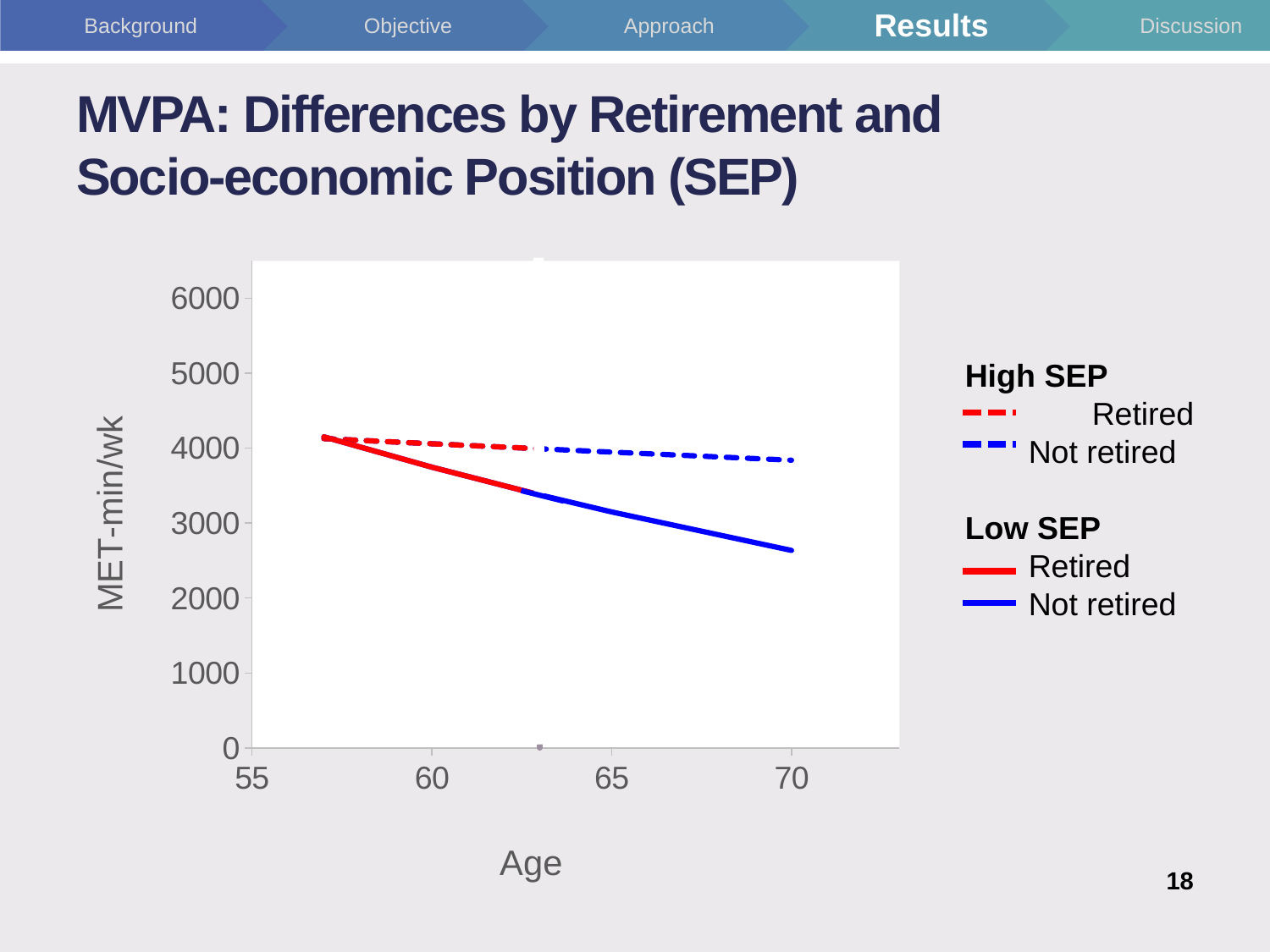
Do the MET-min/wk values for the High SEP Not retired series rise or fall as age increases? fall What kind of chart is shown on the slide? line chart How many series does the legend list in total? 4 What is the label on the x axis of the chart? Age Is the value for the High SEP Not retired series at age 70 greater or less than 3000? greater What is the label on the y axis of the chart? MET-min/wk Is the value for the High SEP Not retired series at age 70 greater or less than 4000? less At age 70, which series has the higher value: High SEP Not retired or Low SEP Not retired? High SEP Not retired Do the MET-min/wk values for the Low SEP Not retired series rise or fall as age increases? fall Is the value for the Low SEP Retired series at age 62 greater or less than 4000? less Which series has the lowest value at age 70? Low SEP Not retired